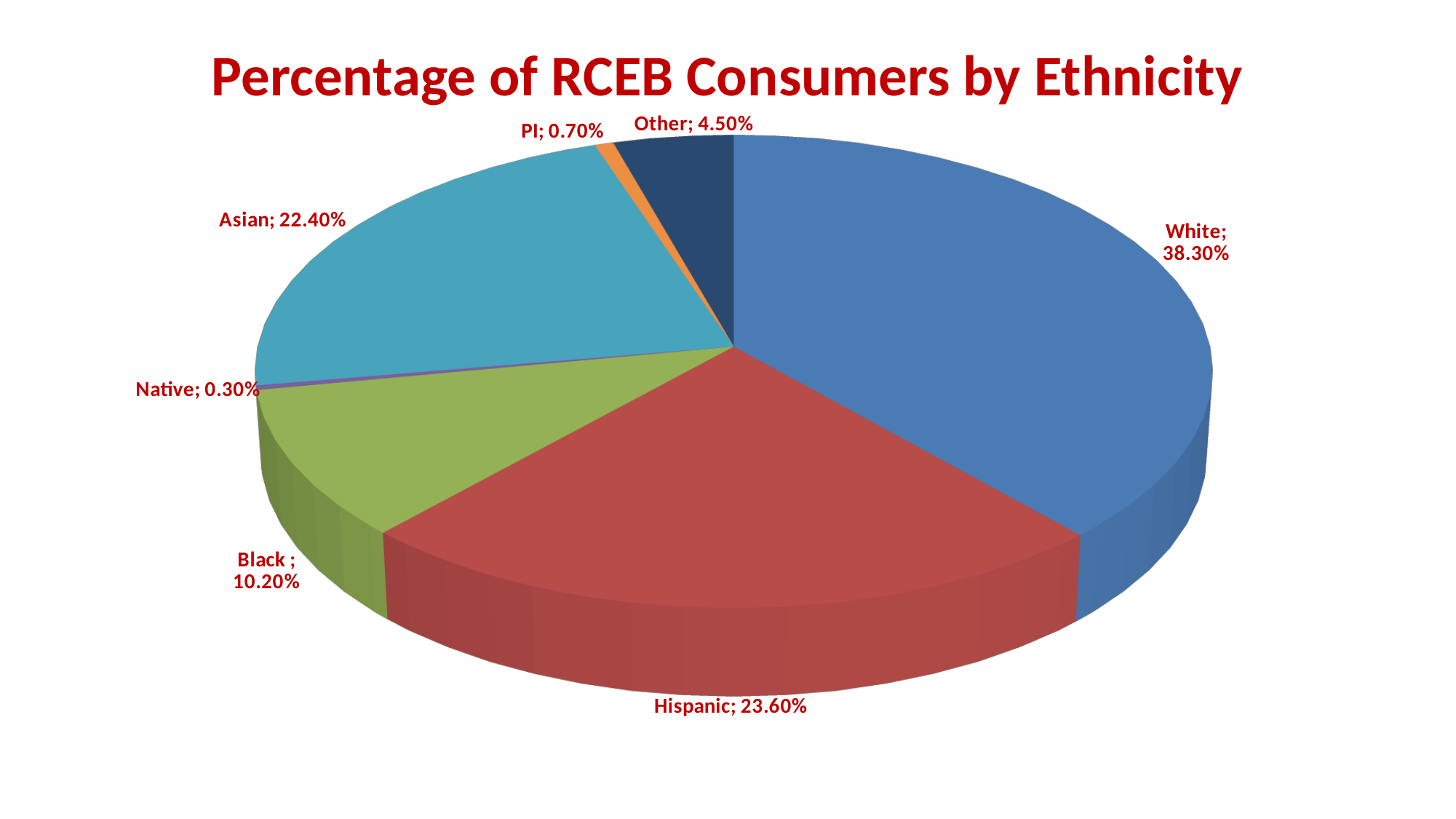
What percentage of RCEB consumers are White? 38.30% What kind of chart is shown on the slide? Pie chart Which ethnicity has the largest share of RCEB consumers? White How many ethnicity categories are shown in the pie chart? 7 What is the difference between the White and Hispanic percentages? 14.70% Which ethnicity has the smallest share of RCEB consumers? Native Which is larger, the Hispanic share or the Asian share? Hispanic What is the title of the chart? Percentage of RCEB Consumers by Ethnicity What percentage of RCEB consumers are listed as Other? 4.50% What percentage of RCEB consumers are Asian? 22.40% What percentage of RCEB consumers are Black? 10.20% What percentage of RCEB consumers are Hispanic? 23.60%